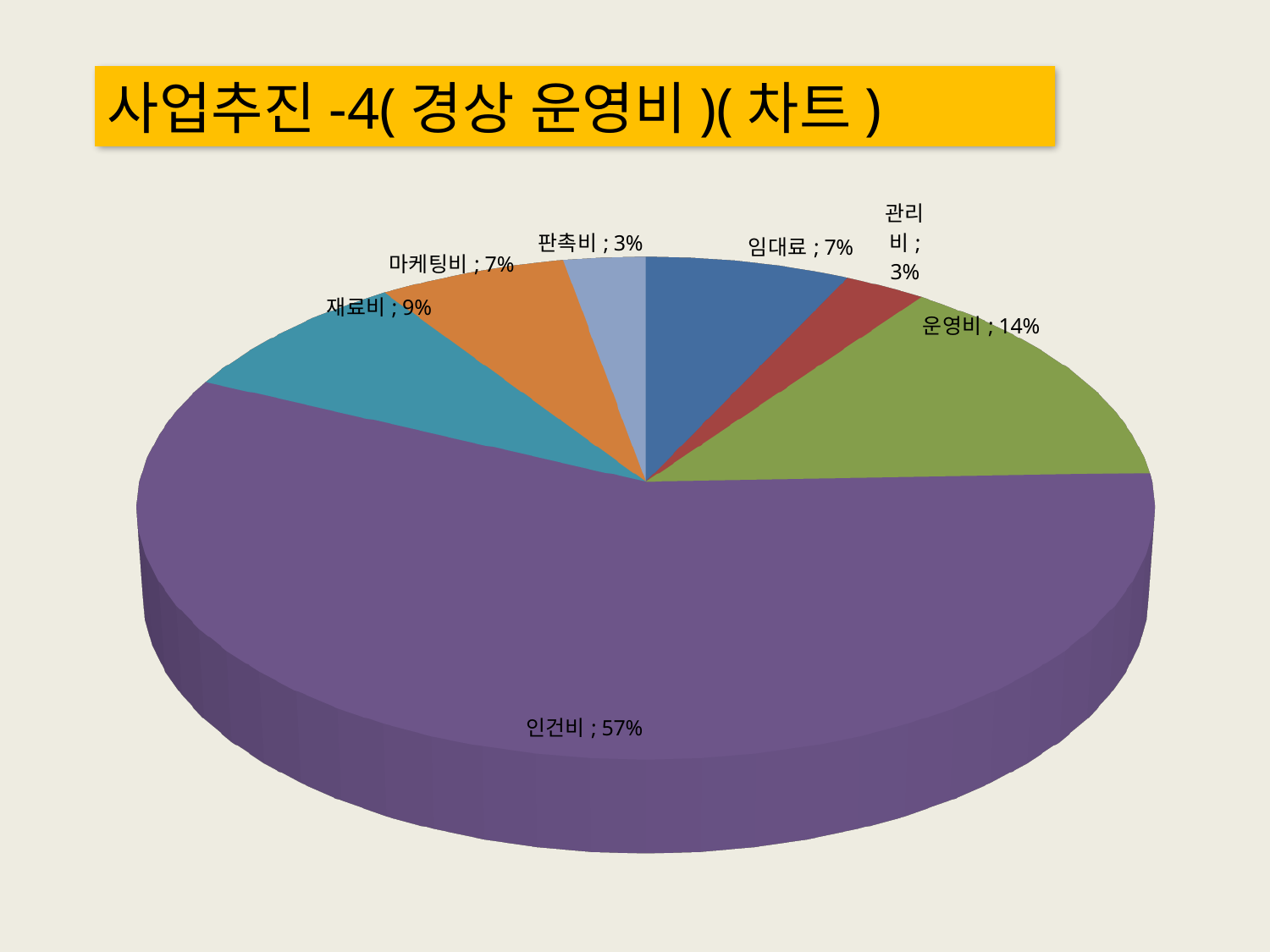
What share of the pie does 운영비 represent? 14% What is the difference between the shares of 인건비 and 운영비? 43% Which category has the largest slice of the pie? 인건비 What kind of chart is shown on the slide? pie chart What is the value shown for 임대료? 7% How many slices does the pie chart have? 7 Which is larger, the share for 재료비 or the share for 마케팅비? 재료비 What is the value shown for 판촉비? 3% What share of the pie does 인건비 represent? 57% What is the title of the slide containing the chart? 사업추진 -4( 경상 운영비 )( 차트 ) What is the difference between the shares of 운영비 and 관리비? 11% What share of the pie does 재료비 represent? 9%